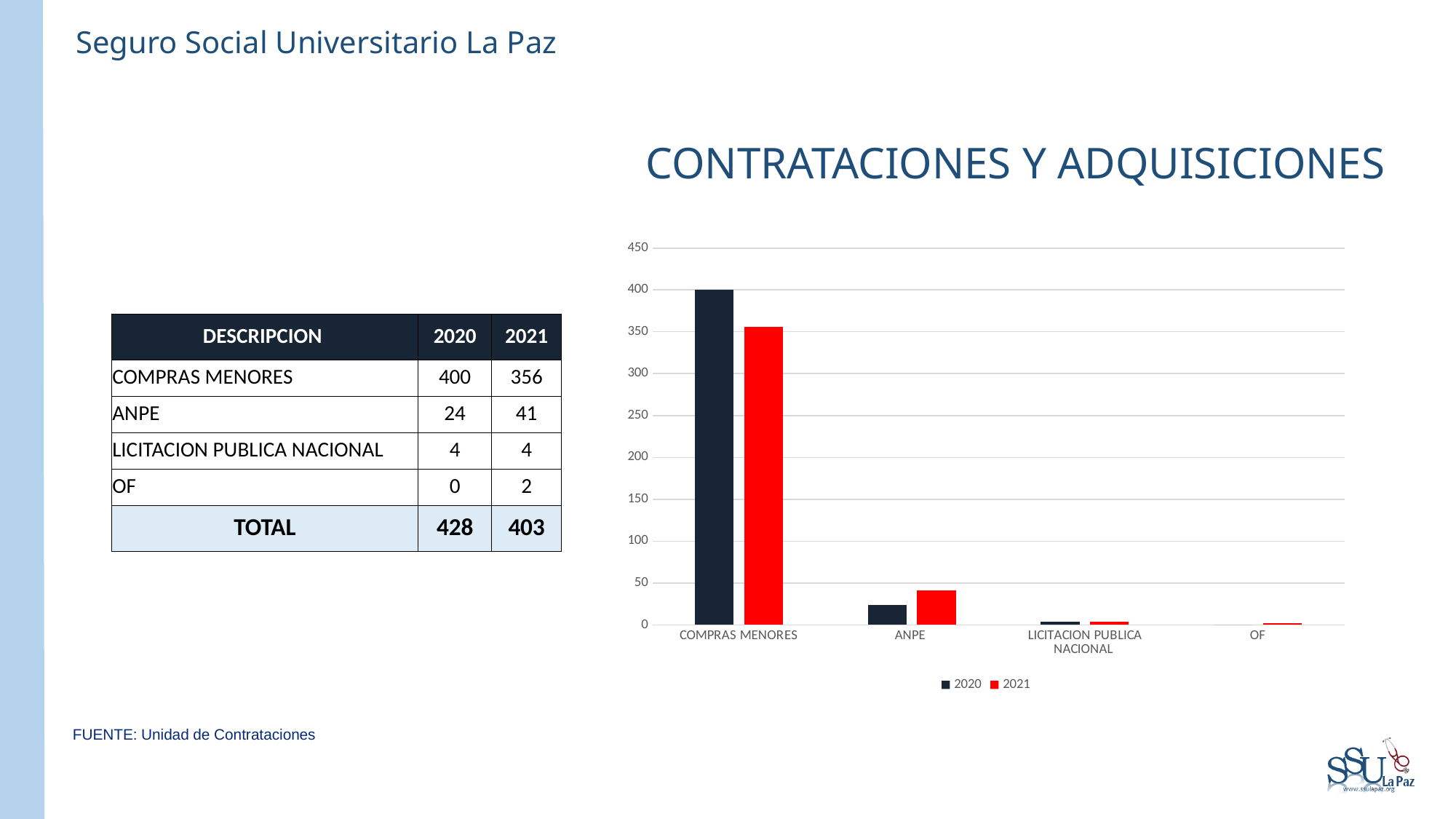
Which colour represents the 2021 series in the chart? red What kind of chart is shown on the slide? bar chart What is the value for ANPE in 2021? 41 How many categories are shown on the x axis of the chart? 4 For ANPE, which year has the larger value, 2020 or 2021? 2021 Which category has the lowest value in 2020? OF Which category has the highest value in 2021? COMPRAS MENORES What is the title of the chart? CONTRATACIONES Y ADQUISICIONES How many series does the chart legend list? 2 What is the difference between the 2020 and 2021 values for COMPRAS MENORES? 44 Is the 2021 value for COMPRAS MENORES greater or less than 300? greater What is the value for COMPRAS MENORES in 2020? 400